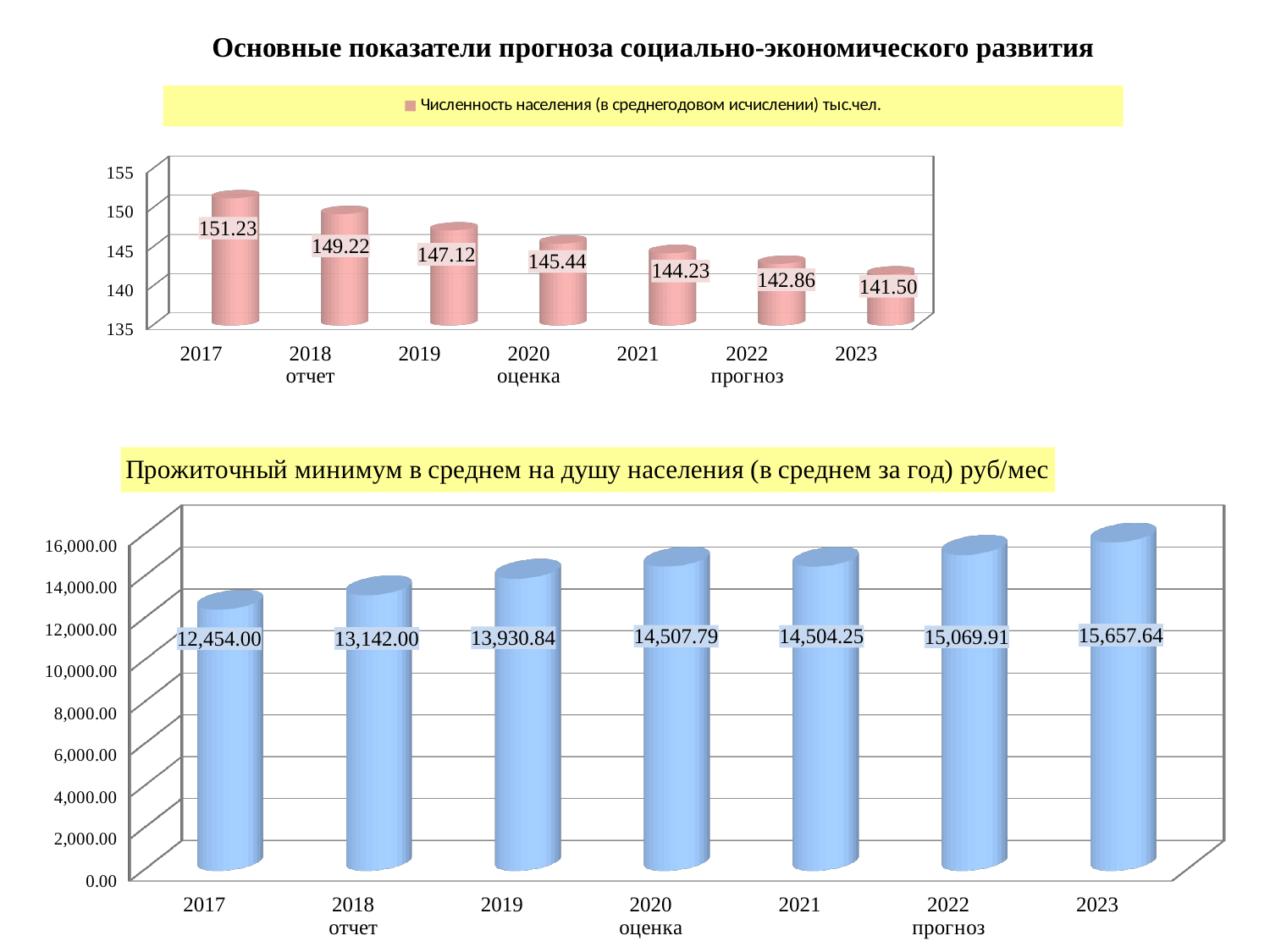
In the bottom chart (Прожиточный минимум), what is the difference between the 2023 and 2017 values? 3,203.64 In the top chart (Численность населения), what is the value for 2017? 151.23 In the bottom chart (Прожиточный минимум), which year has the highest value? 2023 In the top chart (Численность населения), which year has the lowest value? 2023 In the top chart (Численность населения), what is the value for 2023? 141.50 What kind of chart is the bottom chart (Прожиточный минимум)? bar chart In the bottom chart (Прожиточный минимум), what is the value for 2019? 13,930.84 In the bottom chart (Прожиточный минимум), which is larger, the value for 2020 or the value for 2021? 2020 In the top chart (Численность населения), do the values rise or fall from 2017 to 2023? fall In the top chart (Численность населения), what is the difference between the 2017 and 2018 values? 2.01 In the bottom chart (Прожиточный минимум), what is the value for 2022? 15,069.91 In the top chart (Численность населения), how many years are plotted? 7